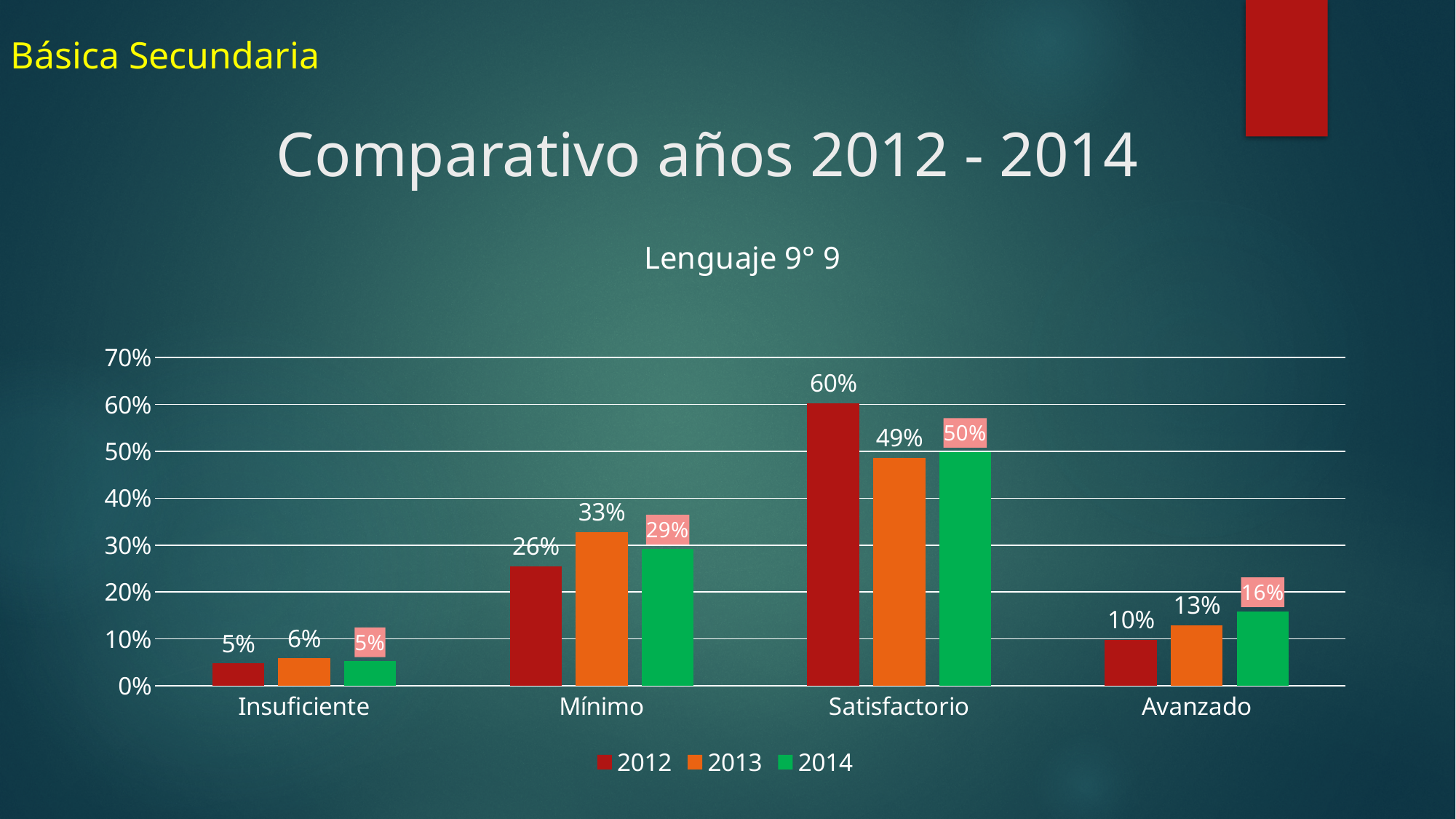
Which category has the highest value for 2013? Satisfactorio Which category has the lowest value for 2014? Insuficiente How many series does the legend list? 3 What is the value for 2014 in the Mínimo category? 29% How many categories are shown on the x axis? 4 What is the value for 2012 in the Satisfactorio category? 60% What is the title of the chart? Lenguaje 9° 9 What is the difference between the 2013 and 2012 values in the Mínimo category? 7% What is the value for 2013 in the Avanzado category? 13% What kind of chart is shown on the slide? Bar chart Which is larger in the Avanzado category, the value for 2012 or the value for 2014? 2014 What is the difference between the 2012 and 2014 values in the Satisfactorio category? 10%